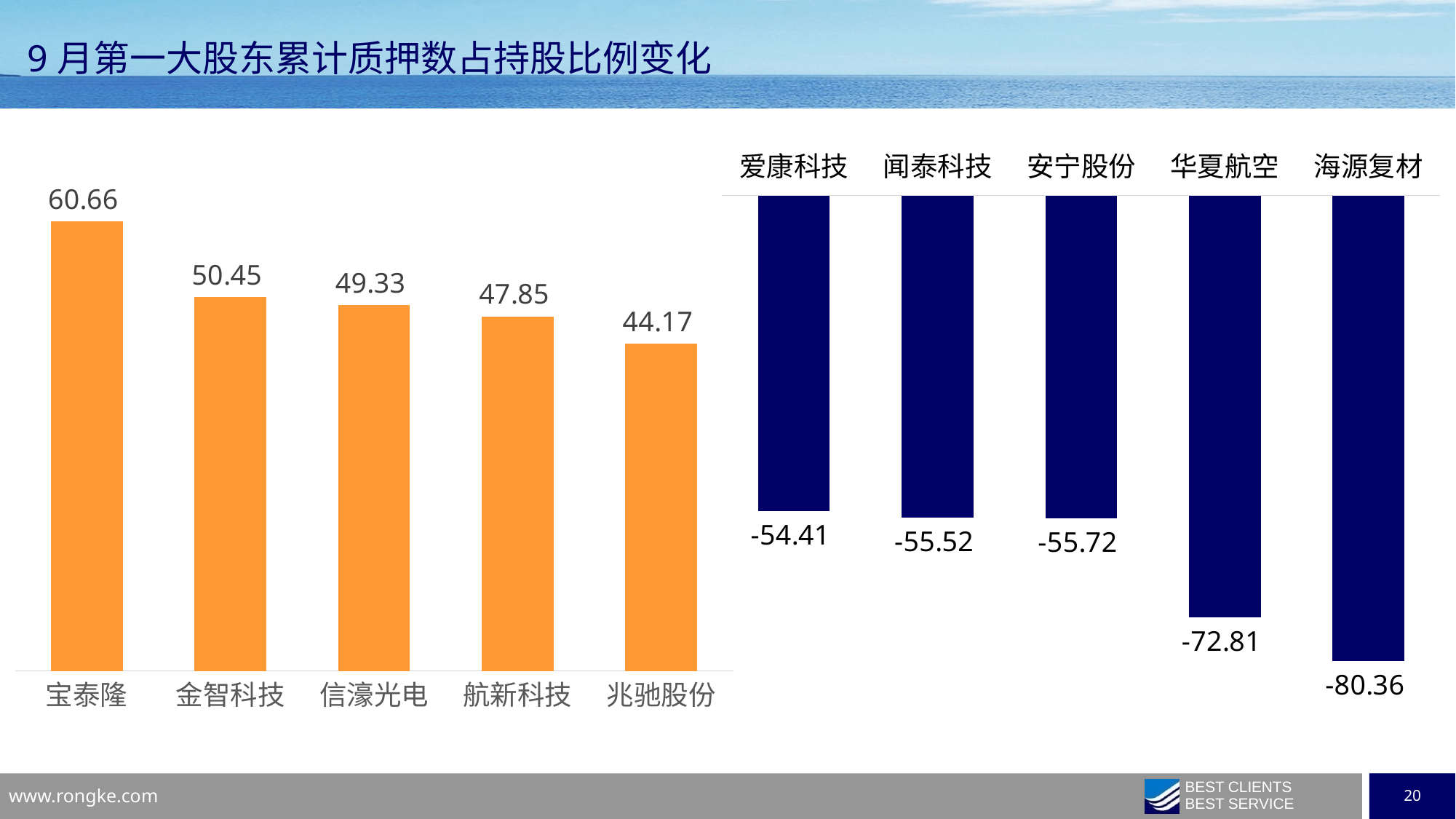
In the left chart, which is larger, the value for 信濠光电 or 航新科技? 信濠光电 In the left chart, which category has the highest value? 宝泰隆 In the left chart, what is the value for 兆驰股份? 44.17 In the right chart, which category has the lowest value? 海源复材 How many categories are shown in the right chart? 5 In the left chart, what is the value for 宝泰隆? 60.66 In the right chart, what is the difference between the values for 华夏航空 and 海源复材? 7.55 In the right chart, what is the value for 华夏航空? -72.81 In the right chart, what is the value for 爱康科技? -54.41 In the left chart, do the values rise or fall from left to right? fall What kind of chart is the left chart? bar chart In the left chart, what is the difference between the values for 宝泰隆 and 金智科技? 10.21